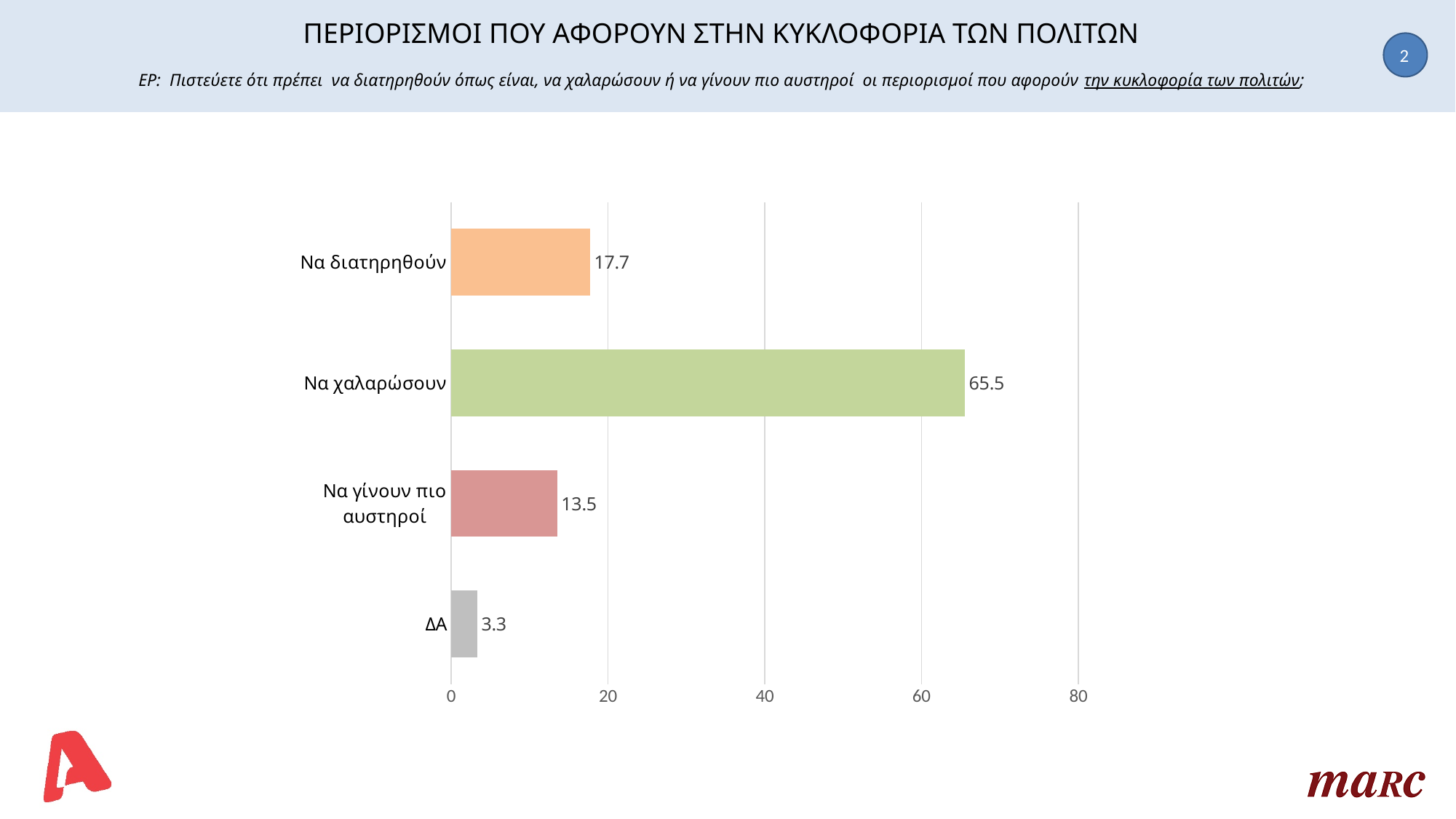
What is the difference between the values for Να διατηρηθούν and Να γίνουν πιο αυστηροί? 4.2 How many categories are shown in the chart? 4 Is the value for Να χαλαρώσουν greater or less than 60? greater Which is larger, the value for Να διατηρηθούν or the value for Να γίνουν πιο αυστηροί? Να διατηρηθούν What kind of chart is shown on the slide? bar chart What is the difference between the values for Να χαλαρώσουν and Να διατηρηθούν? 47.8 What is the value for ΔΑ? 3.3 What is the value for Να γίνουν πιο αυστηροί? 13.5 What is the value for Να διατηρηθούν? 17.7 What is the value for Να χαλαρώσουν? 65.5 Which category has the highest value? Να χαλαρώσουν Which category has the lowest value? ΔΑ